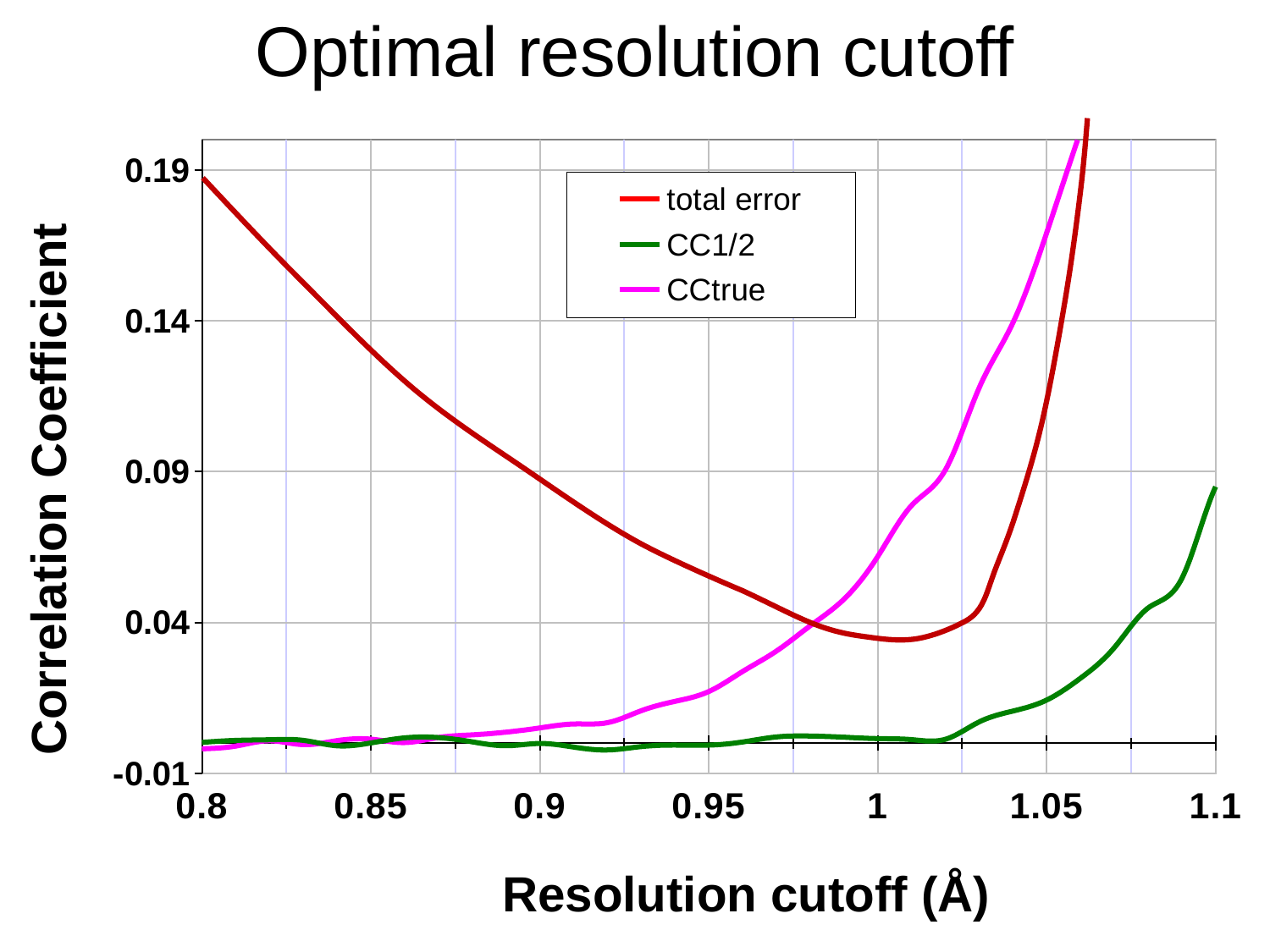
Is the value of CC1/2 at a resolution cutoff of 1.0 greater or less than 0.04? less Which series has the lowest value at a resolution cutoff of 1.05? CC1/2 Is the value of total error at a resolution cutoff of 0.95 greater or less than 0.04? greater At a resolution cutoff of 1.05, which series has the larger value, CCtrue or total error? CCtrue How many series does the legend list? 3 Does the CCtrue series generally rise or fall as the resolution cutoff increases from 0.8 to 1.05? rise At a resolution cutoff of 0.9, which series has the larger value, total error or CCtrue? total error What kind of chart is shown on the slide? line chart Is the value of total error at a resolution cutoff of 0.85 greater or less than 0.14? less What is the label of the x axis? Resolution cutoff (Å) What is the title of the chart? Optimal resolution cutoff